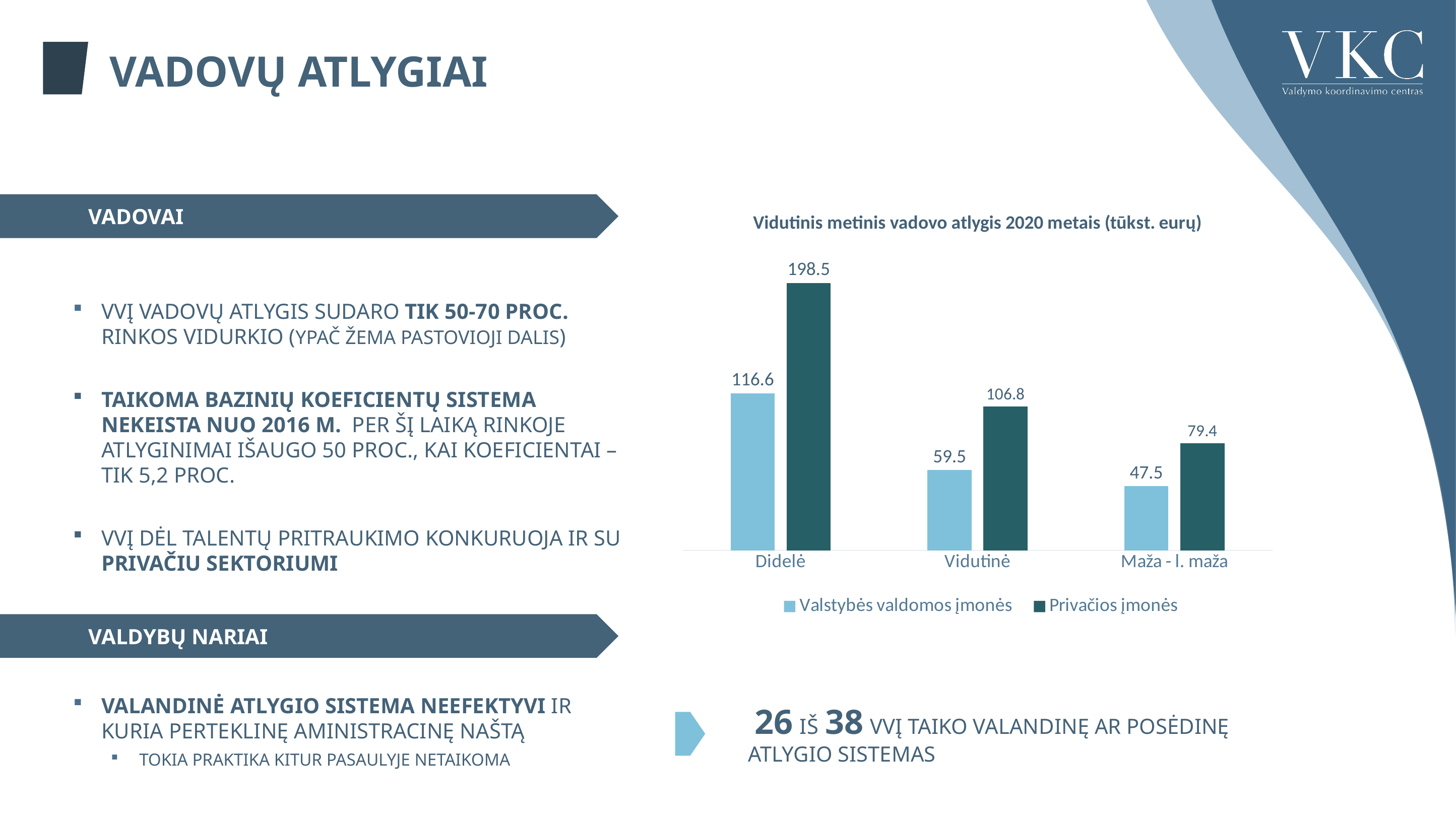
Which is larger in the Maža - l. maža category: Valstybės valdomos įmonės or Privačios įmonės? Privačios įmonės What is the value for Privačios įmonės in the Vidutinė category? 106.8 What is the value for Valstybės valdomos įmonės in the Didelė category? 116.6 What is the title of the chart? Vidutinis metinis vadovo atlygis 2020 metais (tūkst. eurų) How many series does the chart legend list? 2 What is the difference between Privačios įmonės and Valstybės valdomos įmonės in the Didelė category? 81.9 What kind of chart is shown on the slide? Bar chart What is the value for Privačios įmonės in the Maža - l. maža category? 79.4 Which category has the highest value for Privačios įmonės? Didelė Which category has the lowest value for Valstybės valdomos įmonės? Maža - l. maža How many categories are shown on the x axis of the chart? 3 What is the difference between Privačios įmonės and Valstybės valdomos įmonės in the Vidutinė category? 47.3